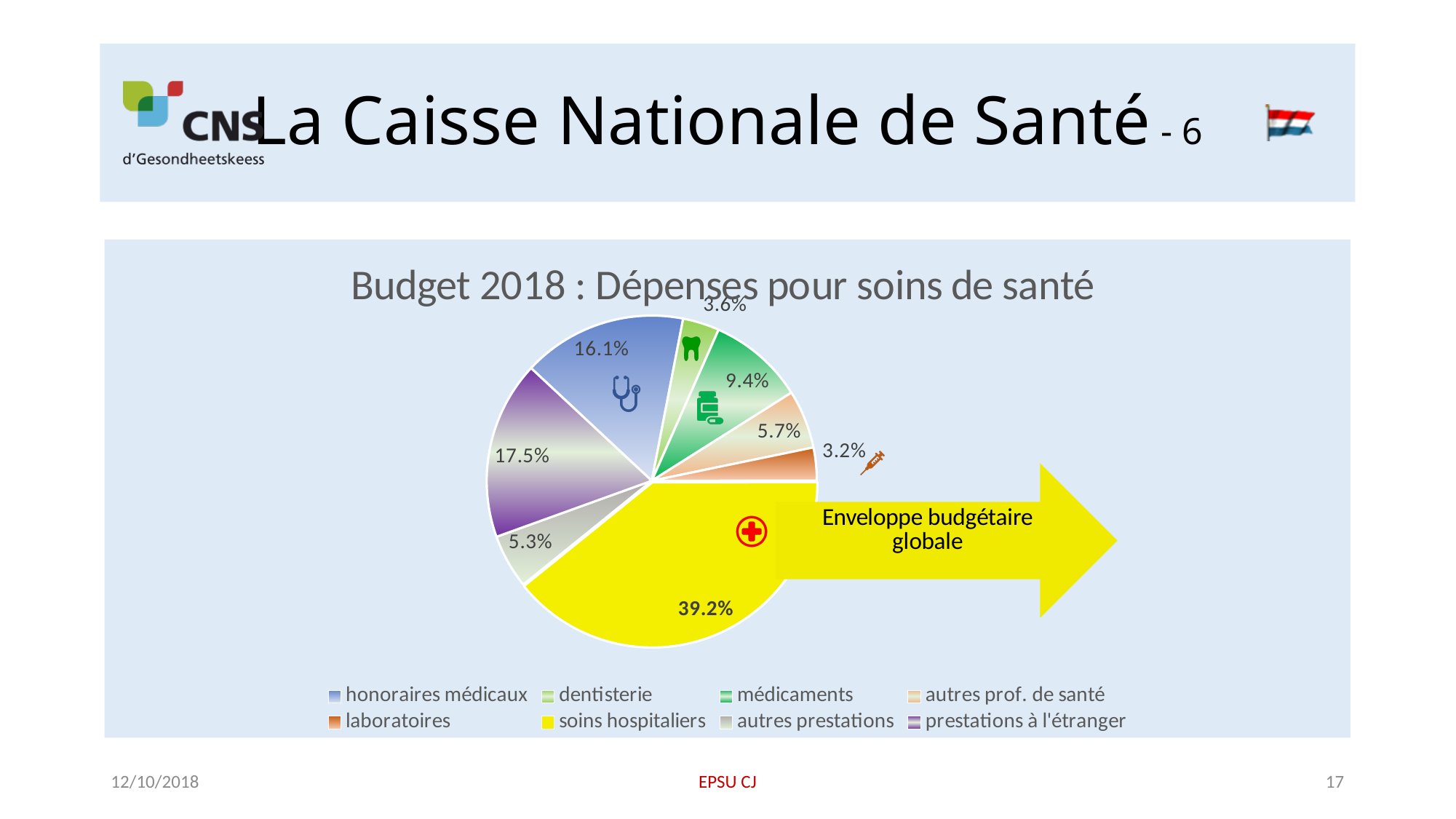
What share of the pie is soins hospitaliers? 39.2% What percentage is shown for médicaments? 9.4% What is the difference in percentage points between prestations à l'étranger and honoraires médicaux? 1.4 What percentage is shown for prestations à l'étranger? 17.5% What is the title of the chart? Budget 2018 : Dépenses pour soins de santé Which is larger, the share for dentisterie or the share for autres prof. de santé? autres prof. de santé Which category has the smallest share of the pie? laboratoires What percentage is shown for laboratoires? 3.2% What type of chart is shown on the slide? pie chart Which category has the largest share of the pie? soins hospitaliers What percentage is shown for honoraires médicaux? 16.1% How many categories does the legend list? 8